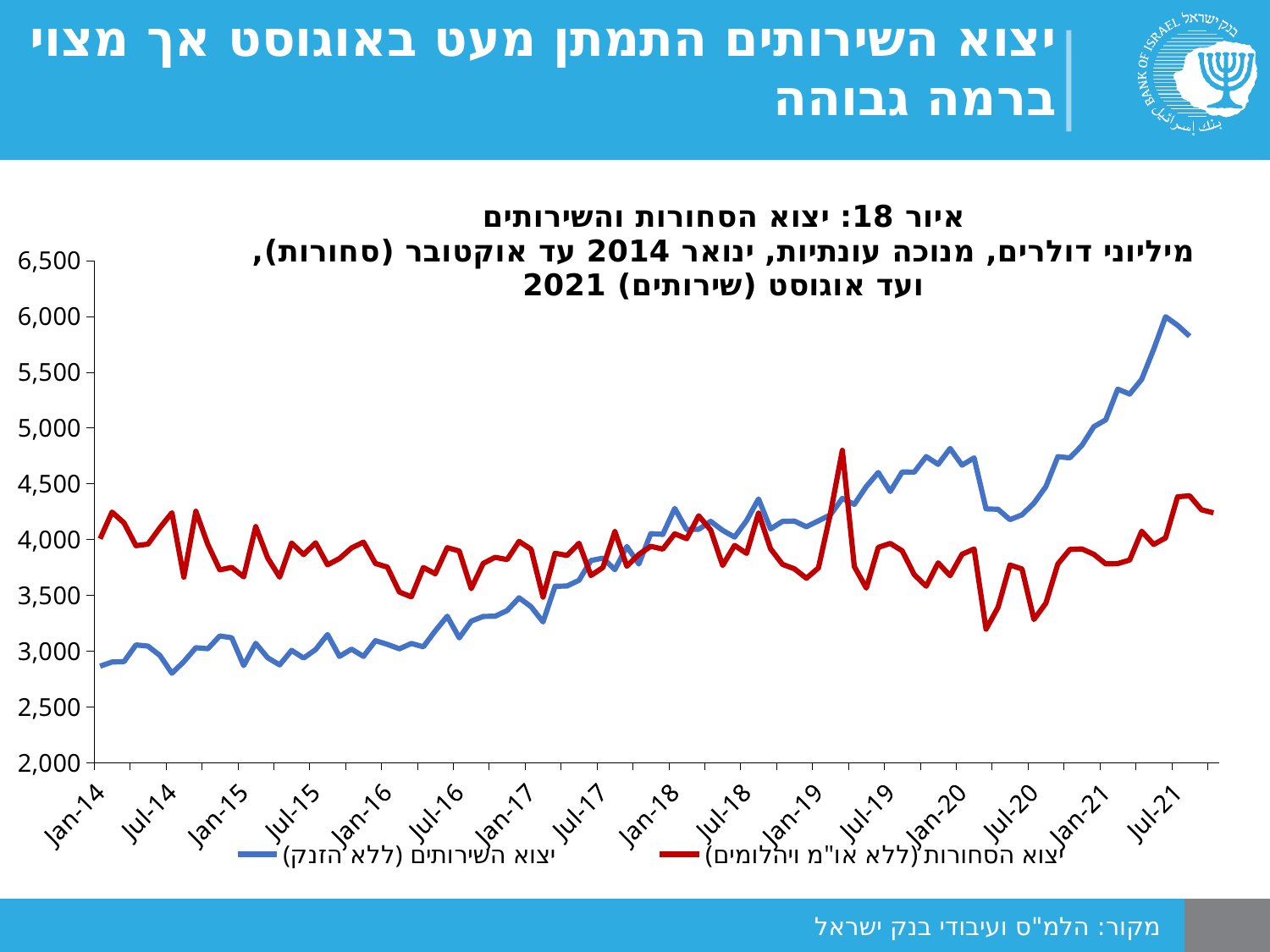
Is the value of the blue services-exports line at Jan-20 greater or less than 4,500? greater Which series is drawn in blue? יצוא השירותים (ללא הזנק) What is the figure number given in the chart title? 18 Is the value of the blue services-exports line at Jan-14 greater or less than 3,000? less How many series does the chart's legend list? 2 Is the highest point of the red goods-exports line (early 2019) greater or less than 4,500? greater At Jan-14, which line is higher: the blue services-exports line or the red goods-exports line? The red goods-exports line At Jan-21, which line is higher: the blue services-exports line or the red goods-exports line? The blue services-exports line What kind of chart is shown on the slide? Line chart Does the blue services-exports line generally rise or fall from Jan-14 to Jul-21? Rise